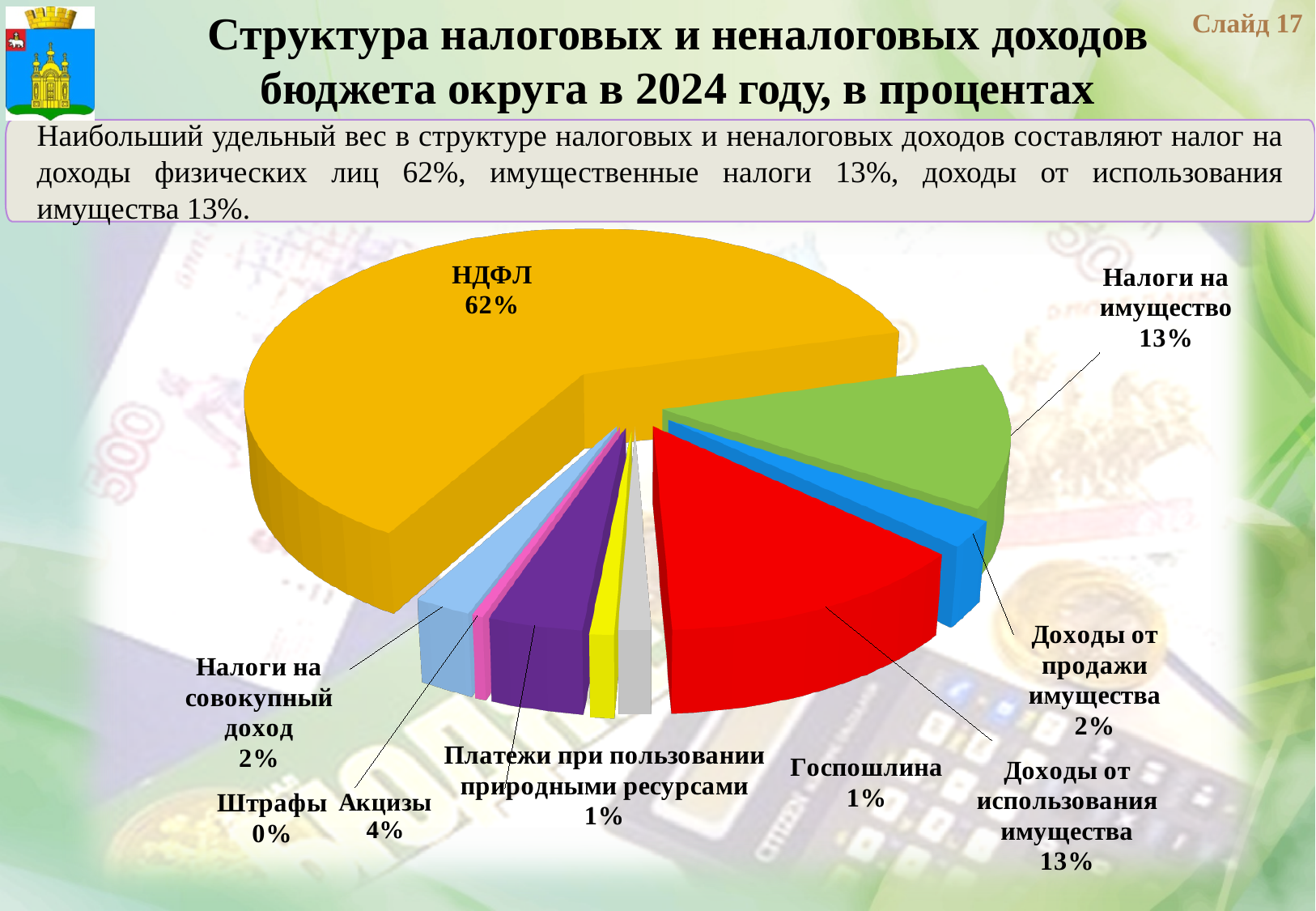
What kind of chart is shown on the slide? pie chart What is the value shown for Госпошлина? 1% What is the value shown for Доходы от продажи имущества? 2% What colour is the НДФЛ slice of the pie? orange (golden-orange) Which category has the largest share of the pie? НДФЛ What is the difference between the shares of НДФЛ and Налоги на имущество? 49% Which category has the smallest share of the pie? Штрафы Which is larger, the share of Акцизы or the share of Налоги на совокупный доход? Акцизы What share of the pie does НДФЛ account for? 62% What is the value shown for Акцизы? 4% How many categories are shown in the pie chart? 9 What is the value shown for Налоги на имущество? 13%